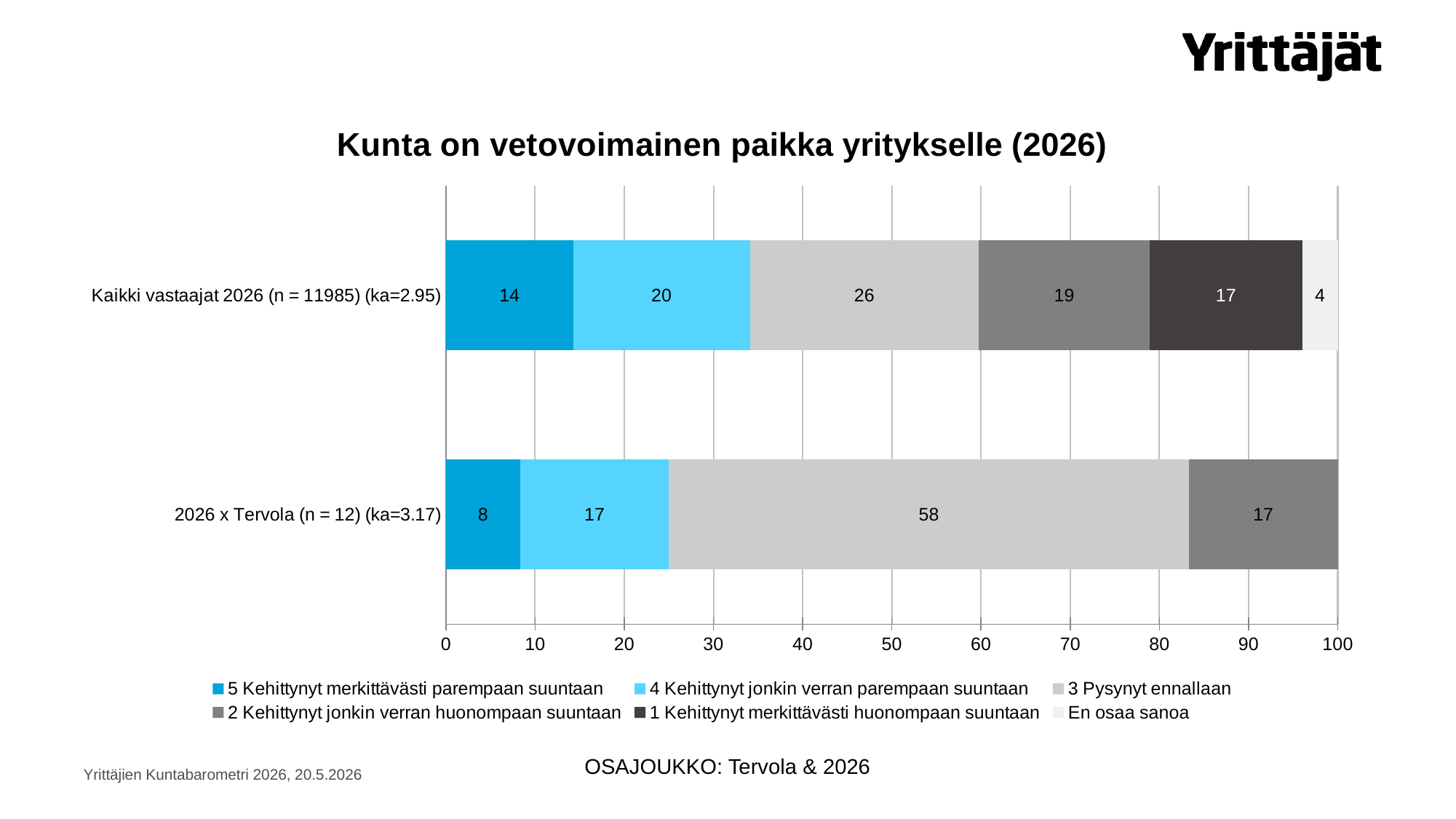
What is the value of "2 Kehittynyt jonkin verran huonompaan suuntaan" for "Kaikki vastaajat 2026 (n = 11985) (ka=2.95)"? 19 What is the value of "5 Kehittynyt merkittävästi parempaan suuntaan" for "Kaikki vastaajat 2026 (n = 11985) (ka=2.95)"? 14 What kind of chart is shown on the slide? bar chart What is the total of the stacked bar for "Kaikki vastaajat 2026 (n = 11985) (ka=2.95)"? 100 What is the value of "En osaa sanoa" for "Kaikki vastaajat 2026 (n = 11985) (ka=2.95)"? 4 Which series has the largest value in the "2026 x Tervola (n = 12) (ka=3.17)" bar? 3 Pysynyt ennallaan How many categories (bars) does the chart show? 2 What is the value of "3 Pysynyt ennallaan" for "2026 x Tervola (n = 12) (ka=3.17)"? 58 What is the difference between the "3 Pysynyt ennallaan" values for "2026 x Tervola" and "Kaikki vastaajat 2026"? 32 What is the title of the chart? Kunta on vetovoimainen paikka yritykselle (2026) Which category has the larger value for "4 Kehittynyt jonkin verran parempaan suuntaan": "Kaikki vastaajat 2026" or "2026 x Tervola"? Kaikki vastaajat 2026 (n = 11985) (ka=2.95) How many series does the legend list? 6